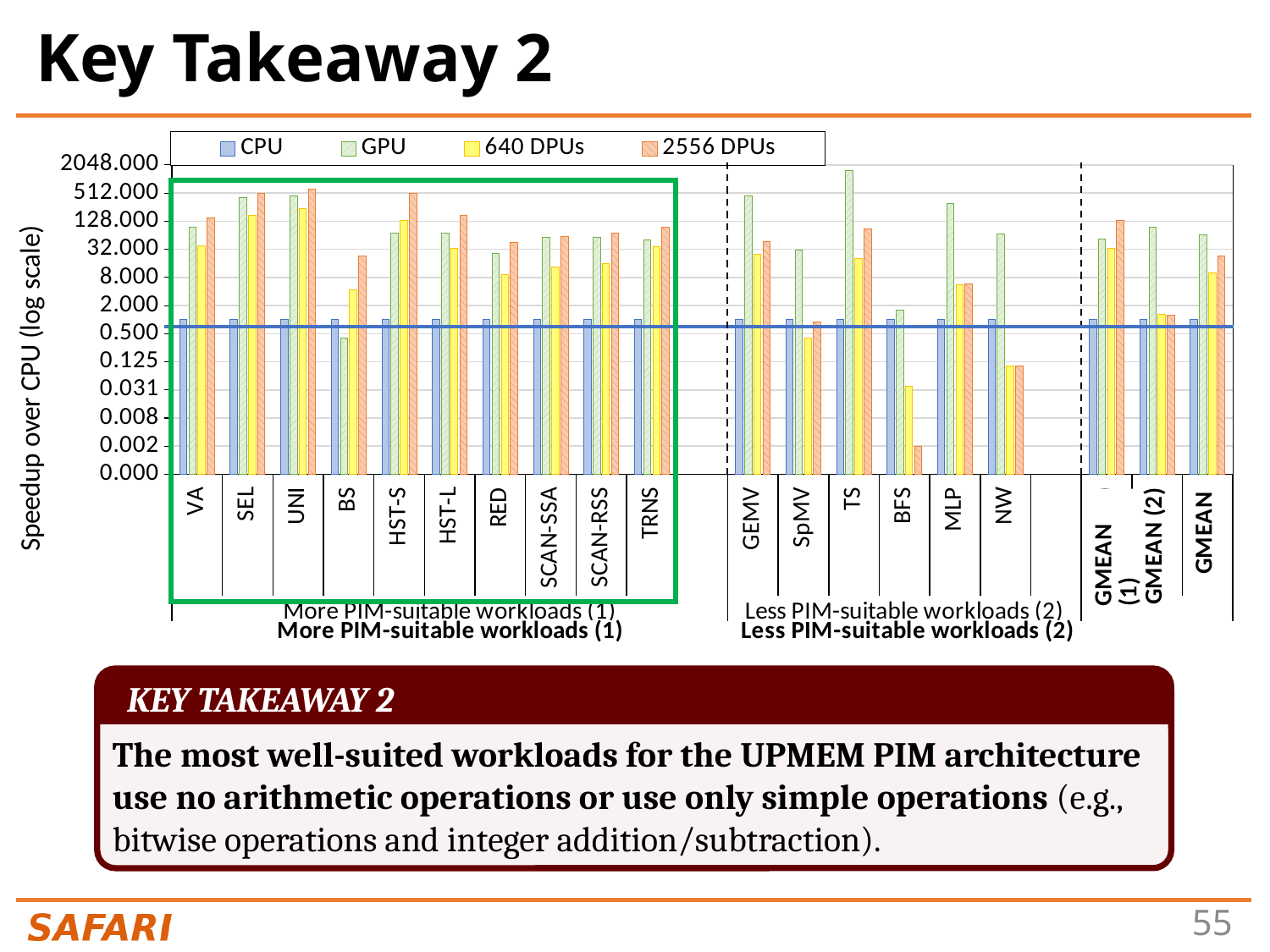
What is the label of the y axis? Speedup over CPU (log scale) Is the GPU value for TS greater or less than 512? greater Is the 2556 DPUs value for BS greater or less than 8? greater How many series does the legend list? 4 Is the 640 DPUs value for NW greater or less than 0.5? less Which workload has the lowest 2556 DPUs bar? BFS What kind of chart is shown on the slide? bar chart For BS, which is larger: the GPU value or the 2556 DPUs value? 2556 DPUs How many workloads are in the 'More PIM-suitable workloads (1)' group? 10 Which workload has the highest GPU bar? TS For GEMV, which is larger: the GPU value or the 640 DPUs value? GPU